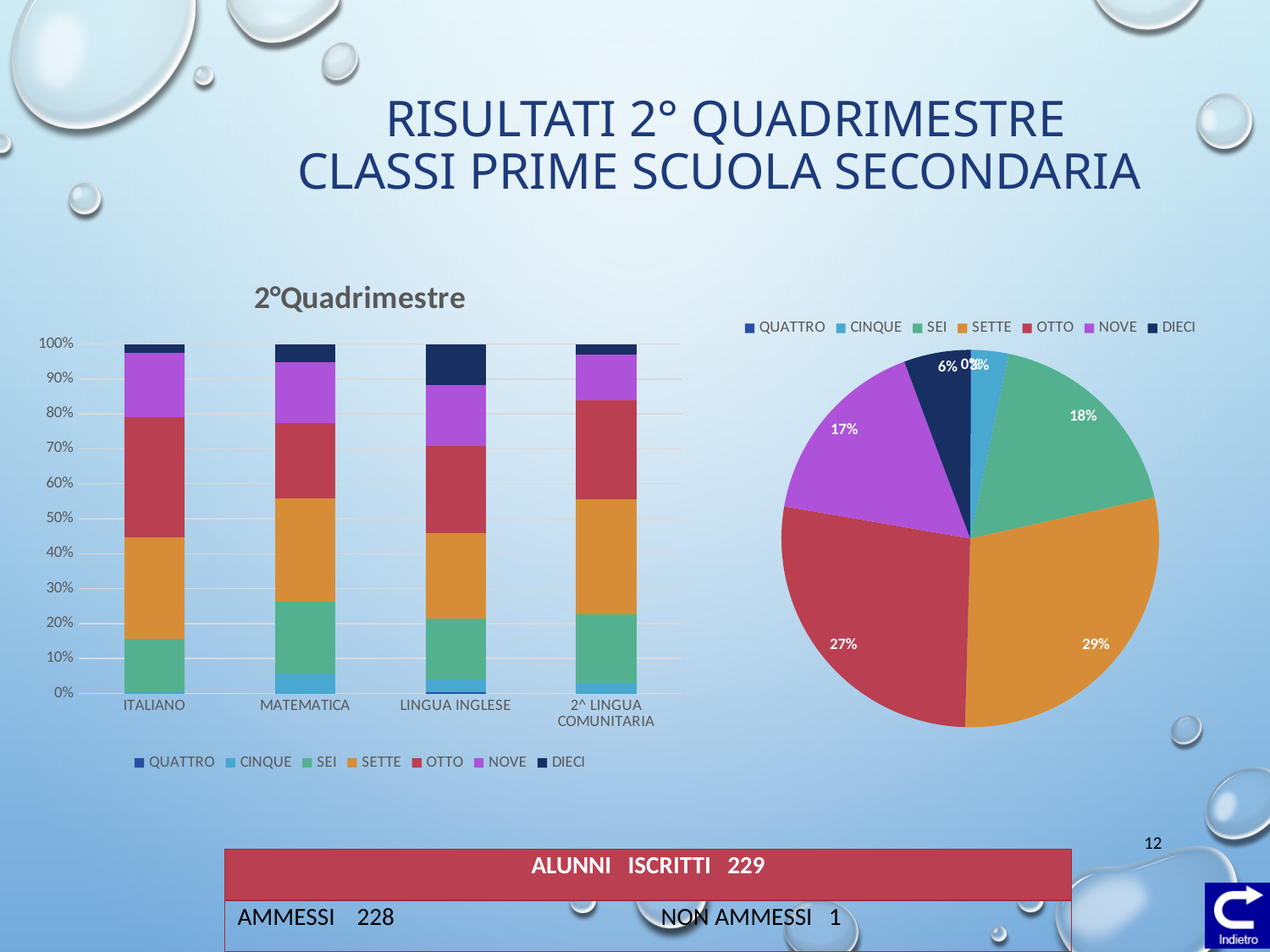
What kind of chart is the chart on the right of the slide? pie chart What kind of chart is the chart titled 2°Quadrimestre? bar chart How many categories are shown on the x axis of the chart titled 2°Quadrimestre? 4 In the pie chart, what share does SETTE have? 29% In the pie chart, what share does NOVE have? 17% In the pie chart, which slice is larger, SEI or NOVE? SEI In the pie chart, which grade has the largest slice? SETTE How many series does the legend of the chart titled 2°Quadrimestre list? 7 In the pie chart, what share does DIECI have? 6% In the pie chart, what share does SEI have? 18% In the pie chart, what is the difference between the SETTE and OTTO shares? 2% In the pie chart, what share does OTTO have? 27%